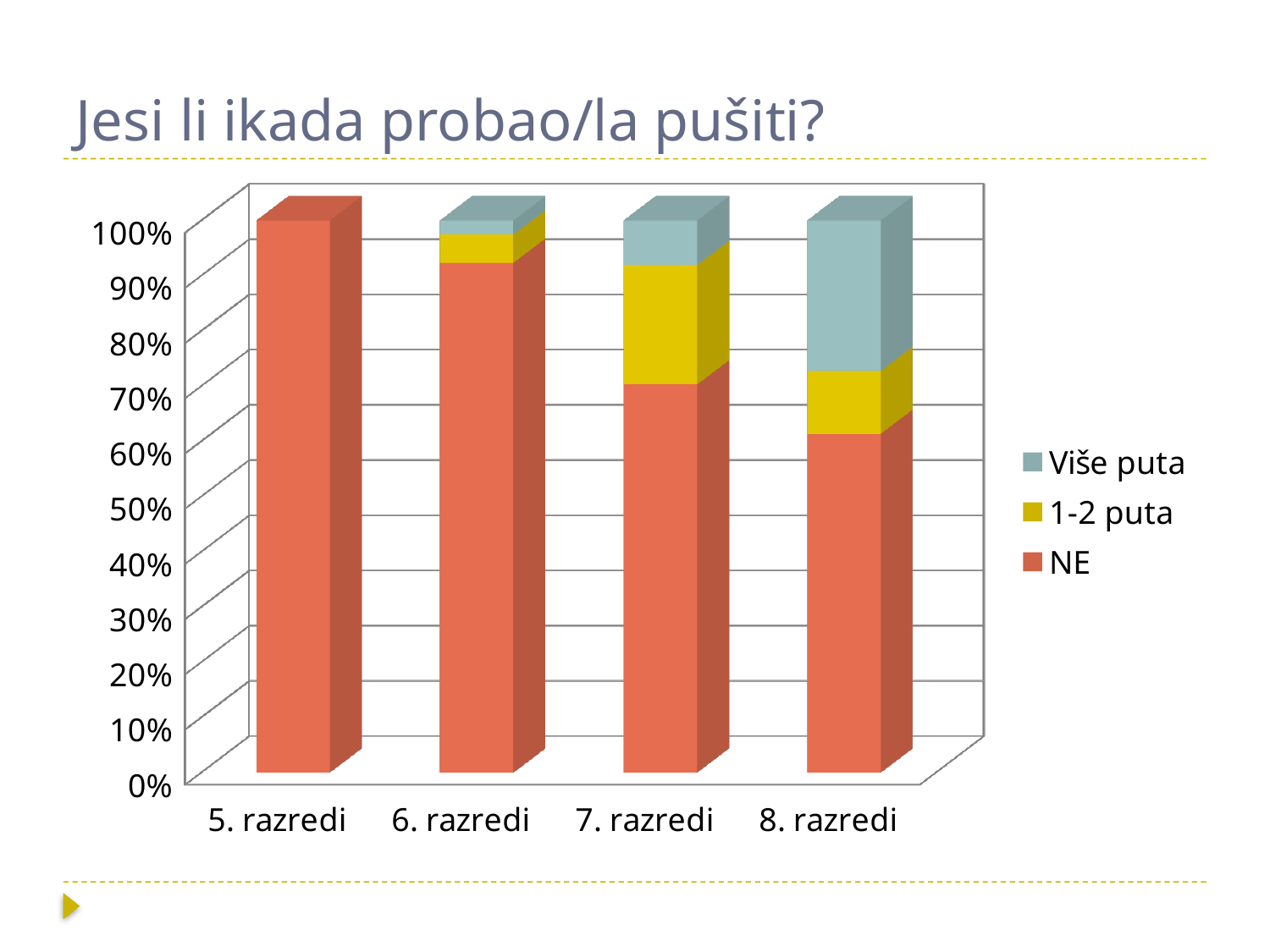
What is the value for NE in 5. razredi? 100% How many series does the legend list? 3 Which category has the highest share of NE? 5. razredi Is the share of NE in 7. razredi greater or less than 80%? less How many categories (grades) are shown on the x axis? 4 What is the title of the chart? Jesi li ikada probao/la pušiti? What kind of chart is shown on the slide? Stacked bar chart Which series is shown in red/orange in the legend? NE Is the share of NE in 6. razredi greater or less than 90%? greater Which category has the lowest share of NE? 8. razredi Which category has the largest share of Više puta? 8. razredi Does the share of NE rise or fall from 5. razredi to 8. razredi? fall